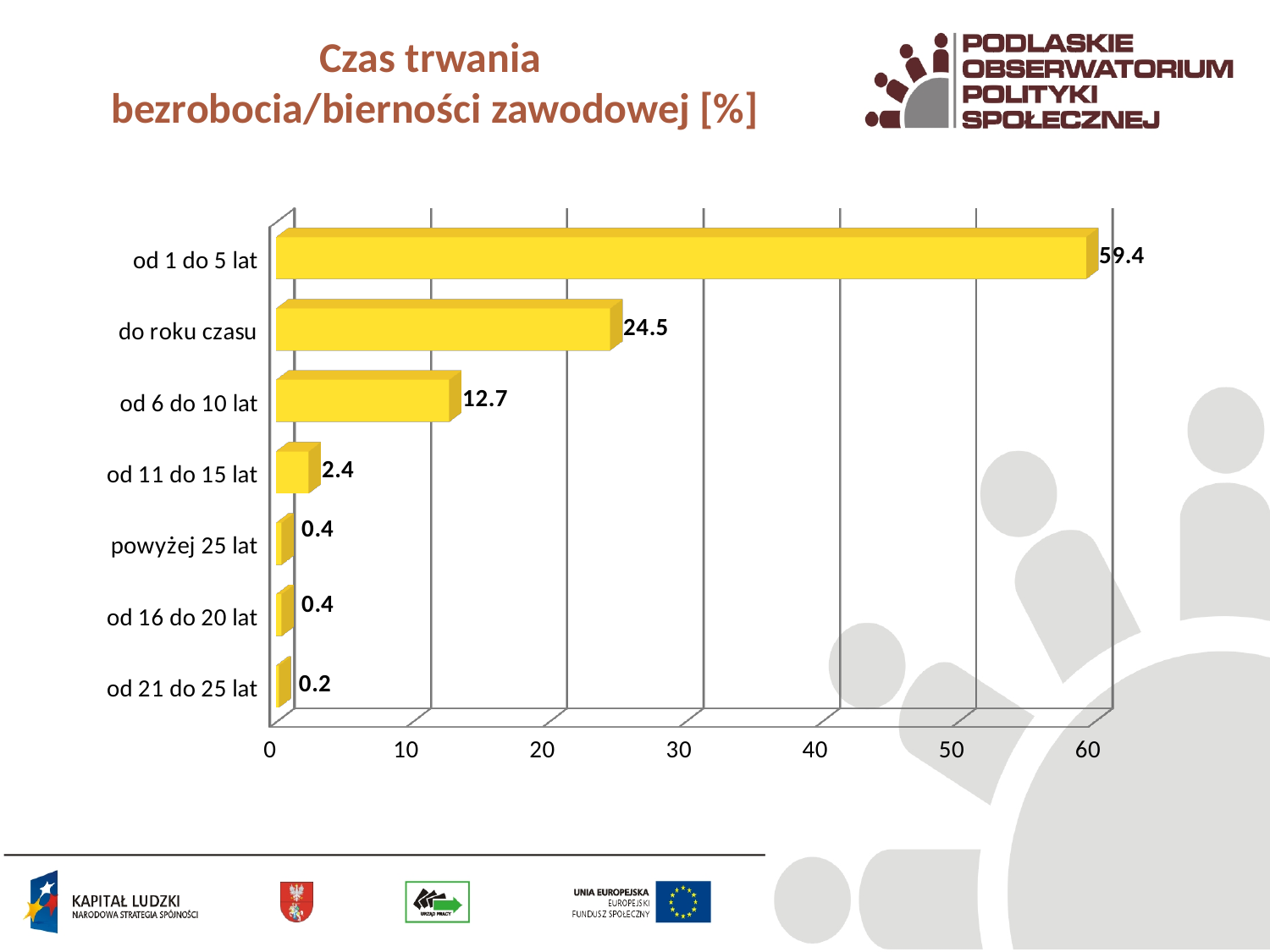
What is the value for "od 11 do 15 lat"? 2.4 What is the value for "od 6 do 10 lat"? 12.7 What is the value for "do roku czasu"? 24.5 What is the title of the chart? Czas trwania bezrobocia/bierności zawodowej [%] How many categories are shown in the chart? 7 What kind of chart is shown on the slide? bar chart Which category has the lowest value? od 21 do 25 lat Which category has the highest value? od 1 do 5 lat What is the value for "od 21 do 25 lat"? 0.2 What is the value for "od 1 do 5 lat"? 59.4 What is the difference between the values for "od 1 do 5 lat" and "do roku czasu"? 34.9 Which is larger, the value for "od 6 do 10 lat" or the value for "od 11 do 15 lat"? od 6 do 10 lat